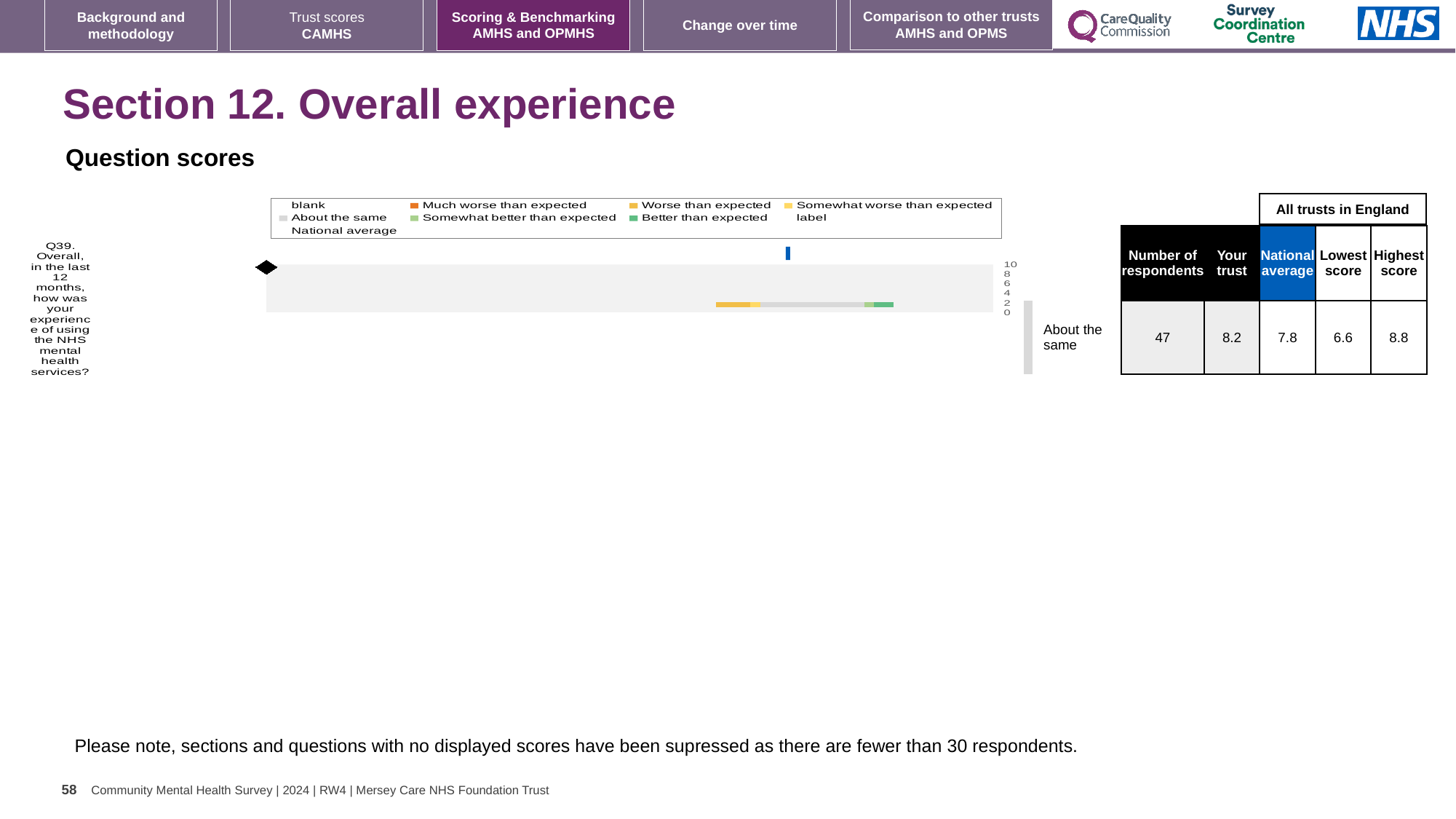
For Q39, which is higher: the trust's score or the national average? Your trust (8.2) Which benchmarking category is the trust's Q39 score placed in? About the same How many respondents answered Q39? 47 What is the national average score for Q39? 7.8 What is the difference between the highest and lowest scores for Q39? 2.2 What kind of chart is shown for Q39 on the slide? bar chart How far below the highest score is the trust's score for Q39? 0.6 By how much does the trust's score for Q39 exceed the national average? 0.4 What is the highest score among all trusts in England for Q39? 8.8 How many questions are plotted in the chart on the slide? 1 What is the 'Your trust' score for Q39 (overall experience of using NHS mental health services)? 8.2 What is the lowest score among all trusts in England for Q39? 6.6